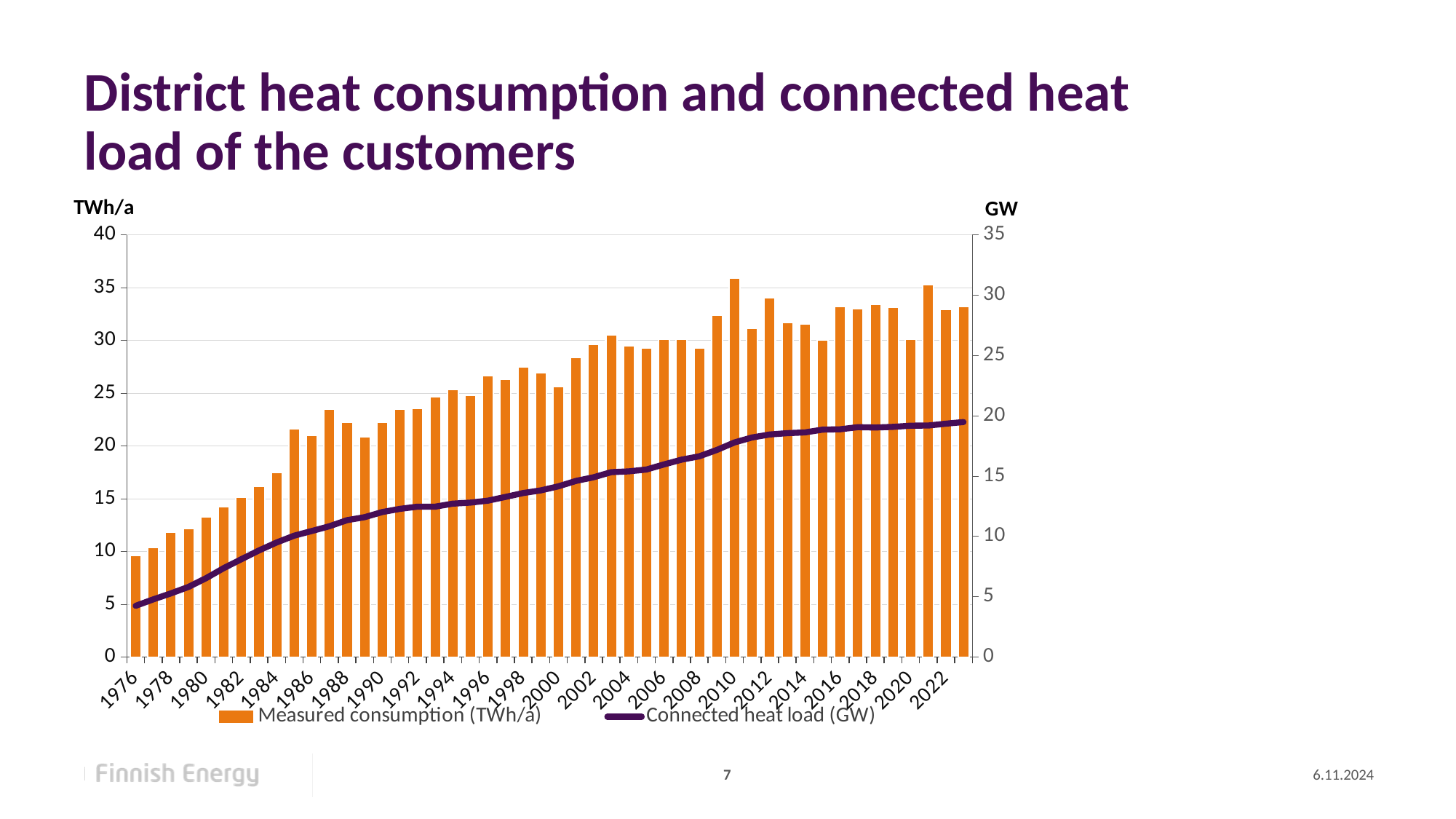
Does the connected heat load line rise or fall from 1976 to 2023? rise What kind of chart is shown on the slide? A bar chart combined with a line chart How many series does the legend list? 2 What are the two series named in the legend? Measured consumption (TWh/a) and Connected heat load (GW) Which year has the highest measured consumption bar? 2010 Is the connected heat load in 2022 greater or less than 20 GW? less Is the measured consumption for 2010 greater or less than 35 TWh/a? greater What unit is shown on the right-hand axis? GW Is the connected heat load in 1976 greater or less than 5 GW? less Which year has the larger measured consumption, 2010 or 2012? 2010 Which year has the lowest measured consumption bar? 1976